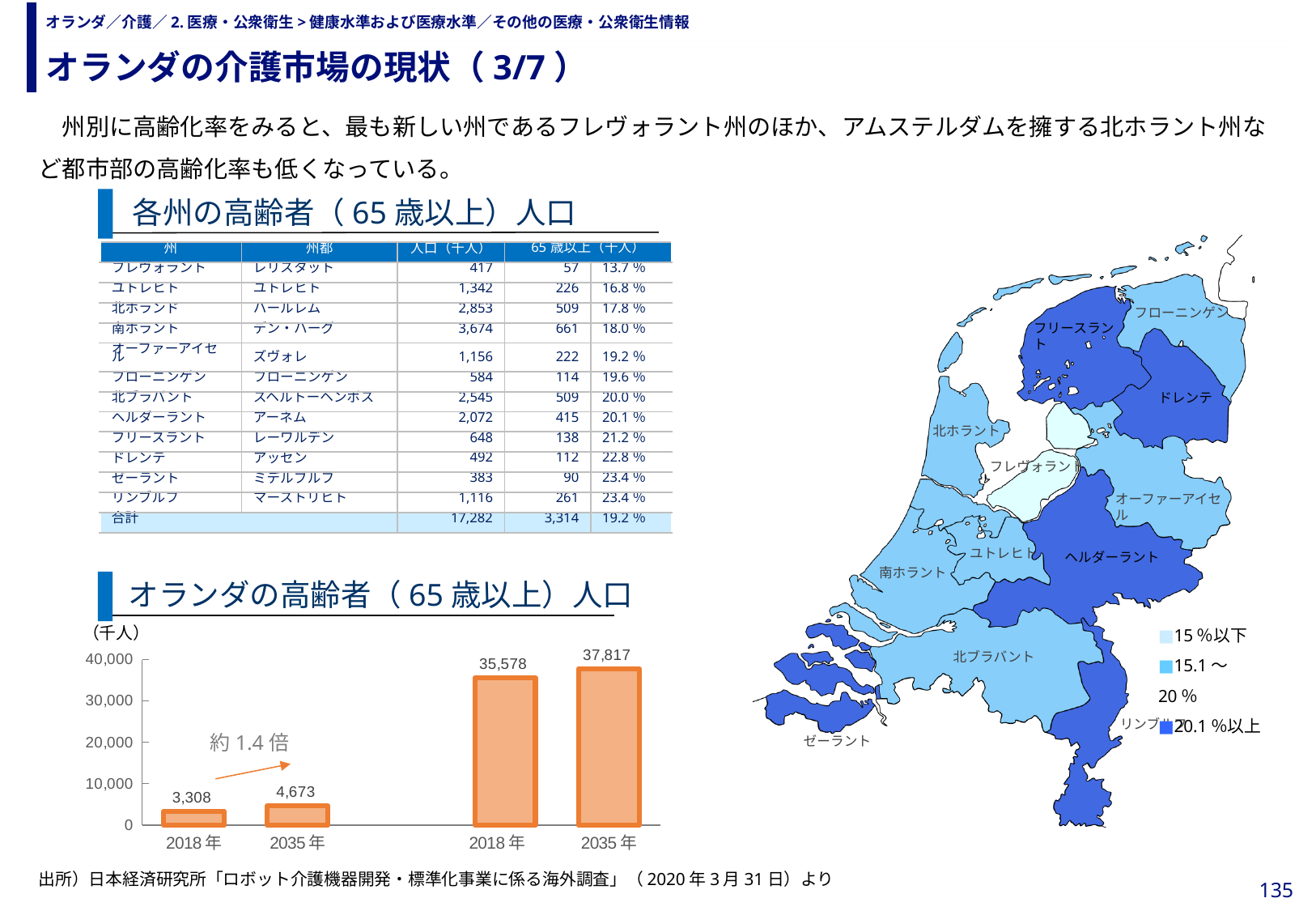
In the bar chart 「オランダの高齢者（65歳以上）人口」, is the value of the second bar from the left (2035年) greater or less than 10,000? less In the bar chart 「オランダの高齢者（65歳以上）人口」, what is the value of the third bar from the left (2018年)? 35,578 In the bar chart 「オランダの高齢者（65歳以上）人口」, what is the highest value shown? 37,817 In the bar chart 「オランダの高齢者（65歳以上）人口」, what is the value of the leftmost bar (2018年)? 3,308 In the bar chart 「オランダの高齢者（65歳以上）人口」, how many bars are plotted? 4 In the bar chart 「オランダの高齢者（65歳以上）人口」, what unit is shown above the vertical axis? 千人 In the bar chart 「オランダの高齢者（65歳以上）人口」, what is the lowest value shown? 3,308 In the bar chart 「オランダの高齢者（65歳以上）人口」, what is the value of the second bar from the left (2035年)? 4,673 What kind of chart is shown under the title 「オランダの高齢者（65歳以上）人口」? bar chart In the bar chart 「オランダの高齢者（65歳以上）人口」, what is the difference between the two right-hand bars (37,817 and 35,578)? 2,239 In the bar chart 「オランダの高齢者（65歳以上）人口」, what is the value of the rightmost bar (2035年)? 37,817 In the bar chart 「オランダの高齢者（65歳以上）人口」, what is the difference between the two left-hand bars (4,673 and 3,308)? 1,365